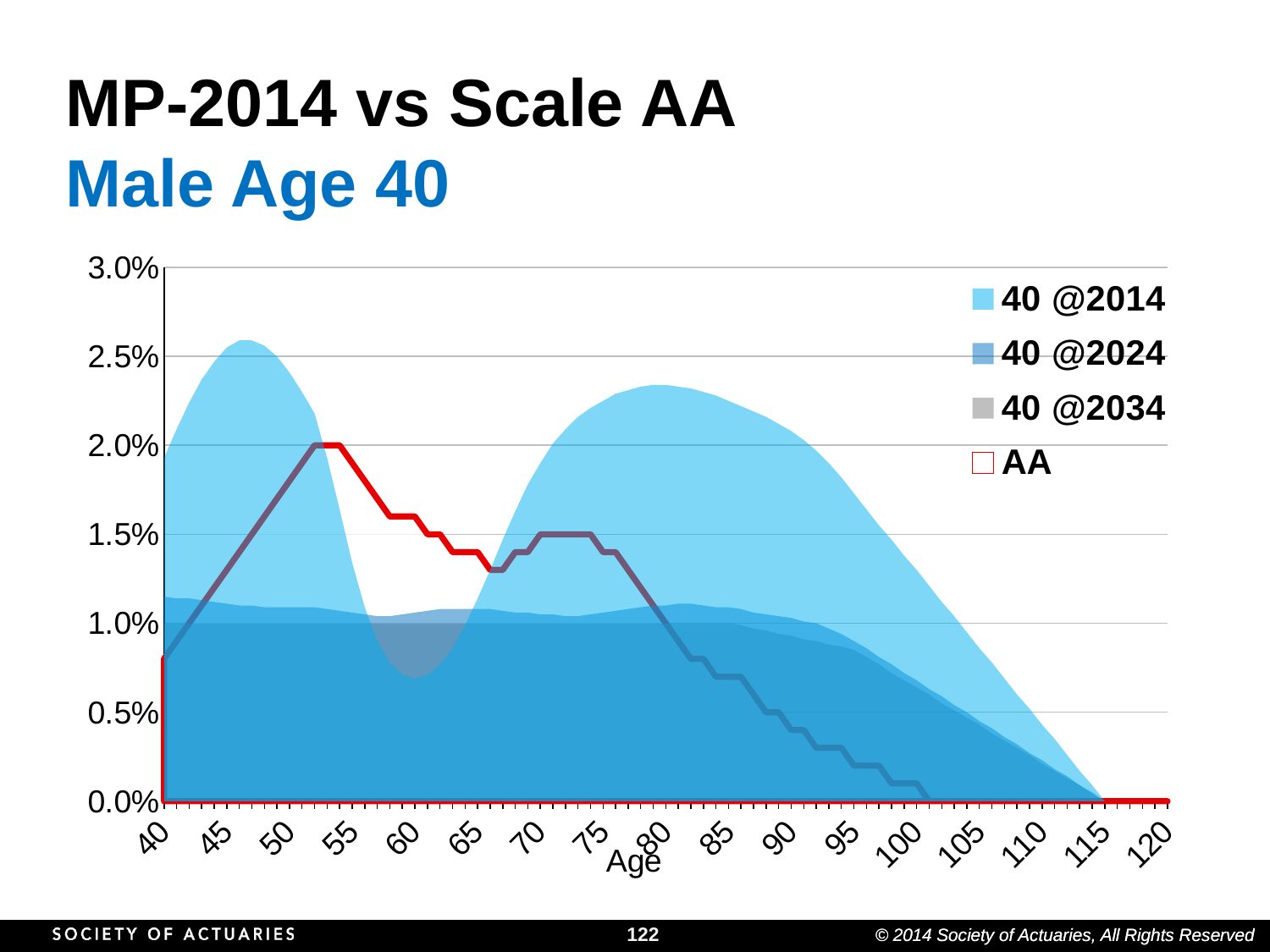
At age 60, which is larger: the AA value or the 40 @2014 value? AA At age 50, which is larger: the 40 @2014 value or the AA value? 40 @2014 How many age labels are shown along the x axis? 17 What is the label of the x axis? Age Is the 40 @2014 value at age 50 greater or less than 2.0%? greater Is the AA value at age 95 greater or less than 0.5%? less Is the AA value at age 40 greater or less than 1.0%? less What is the highest value shown on the y axis? 3.0% How many series does the legend list? 4 What type of chart is shown on the slide? Area chart